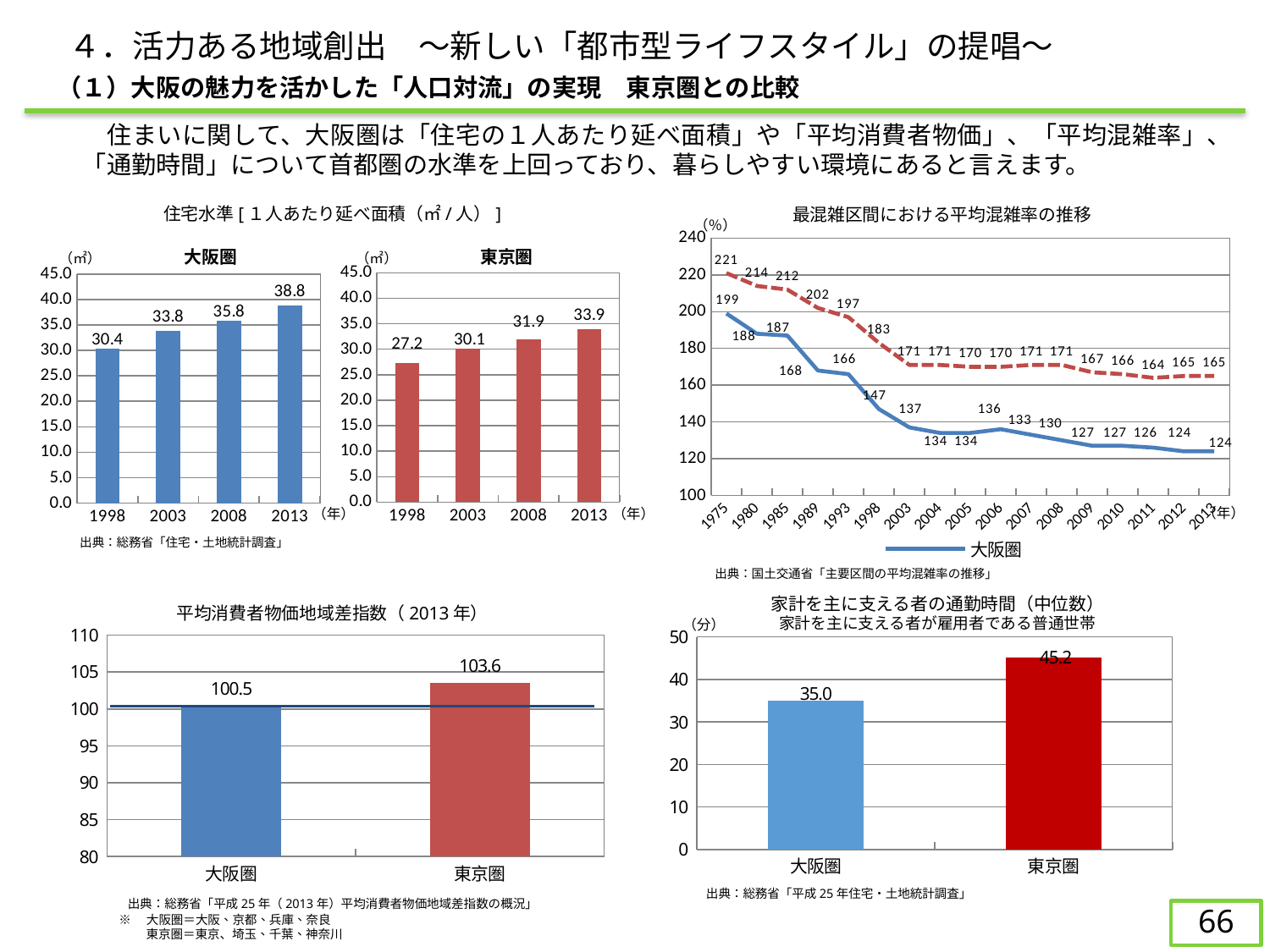
In the 住宅水準 chart for 大阪圏, do the values rise or fall from 1998 to 2013? rise In the 住宅水準 charts, which is larger for 2008: 大阪圏 or 東京圏? 大阪圏 In the 最混雑区間における平均混雑率の推移 chart, what is the value of the 大阪圏 line in 1975? 199 In the 住宅水準 chart for 東京圏, which year has the highest value? 2013 What type of chart is the 家計を主に支える者の通勤時間 chart? bar chart In the 住宅水準 chart for 大阪圏, what is the difference between the 2013 and 1998 values? 8.4 In the 最混雑区間における平均混雑率の推移 chart, does the 大阪圏 line rise or fall from 1975 to 2013? fall In the 平均消費者物価地域差指数 chart, what is the value for 東京圏? 103.6 In the 家計を主に支える者の通勤時間 chart, what is the difference between 東京圏 and 大阪圏? 10.2 In the 住宅水準 chart for 東京圏, what is the value for 1998? 27.2 In the 最混雑区間における平均混雑率の推移 chart, what is the value of the 大阪圏 line in 2013? 124 In the 住宅水準 chart for 大阪圏, what is the value for 2013? 38.8